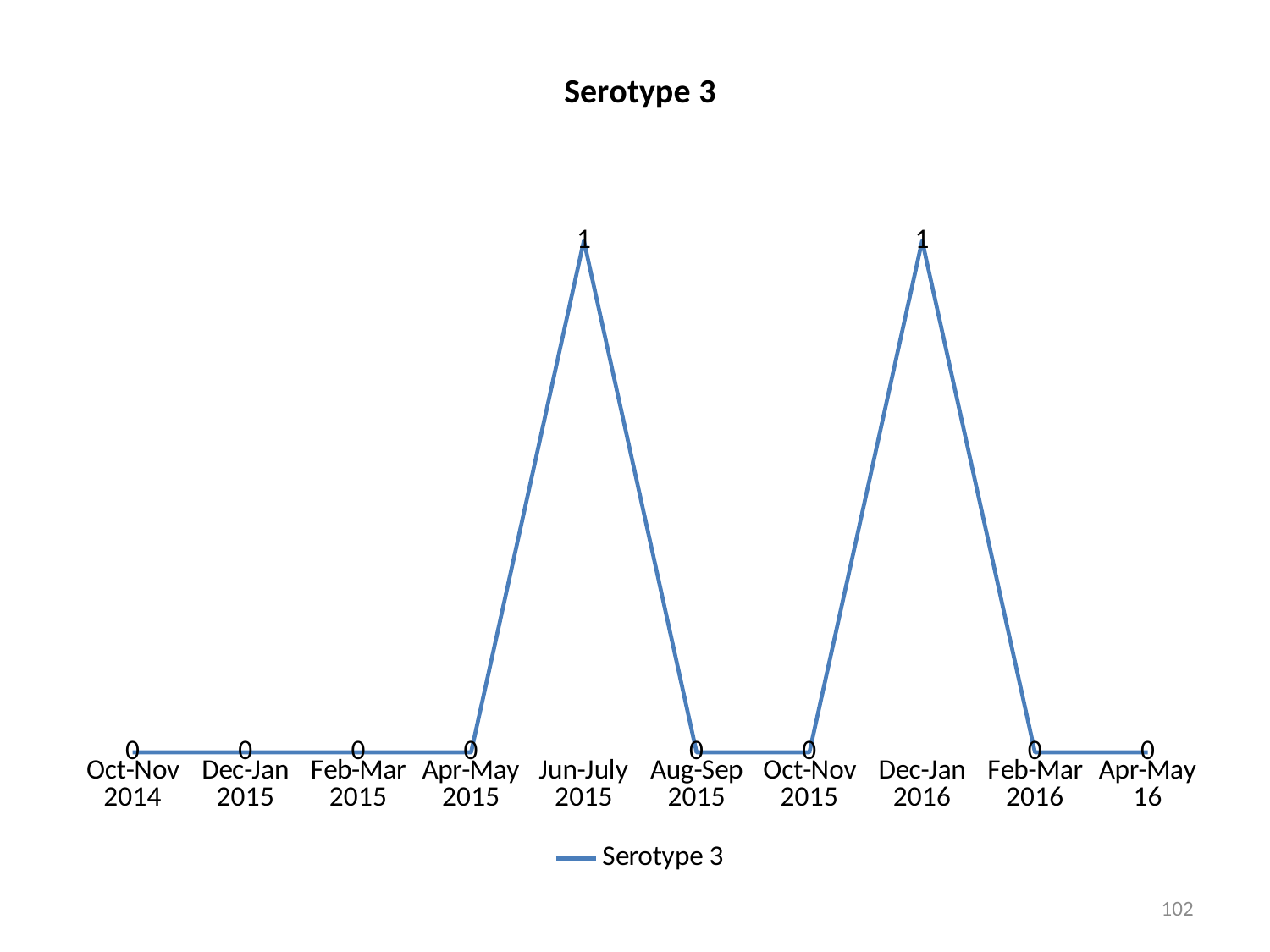
How many series does the legend list? 1 What kind of chart is shown? line chart What is the value for Feb-Mar 2016? 0 What is the value for Jun-July 2015? 1 What is the difference between the values for Jun-July 2015 and Apr-May 2015? 1 How many time periods are plotted on the x axis? 10 What is the value for Aug-Sep 2015? 0 What is the title of the chart? Serotype 3 What is the value for Dec-Jan 2016? 1 How many periods have a value of 1? 2 What is the value for Oct-Nov 2014? 0 Which is larger, the value for Dec-Jan 2016 or the value for Oct-Nov 2015? Dec-Jan 2016